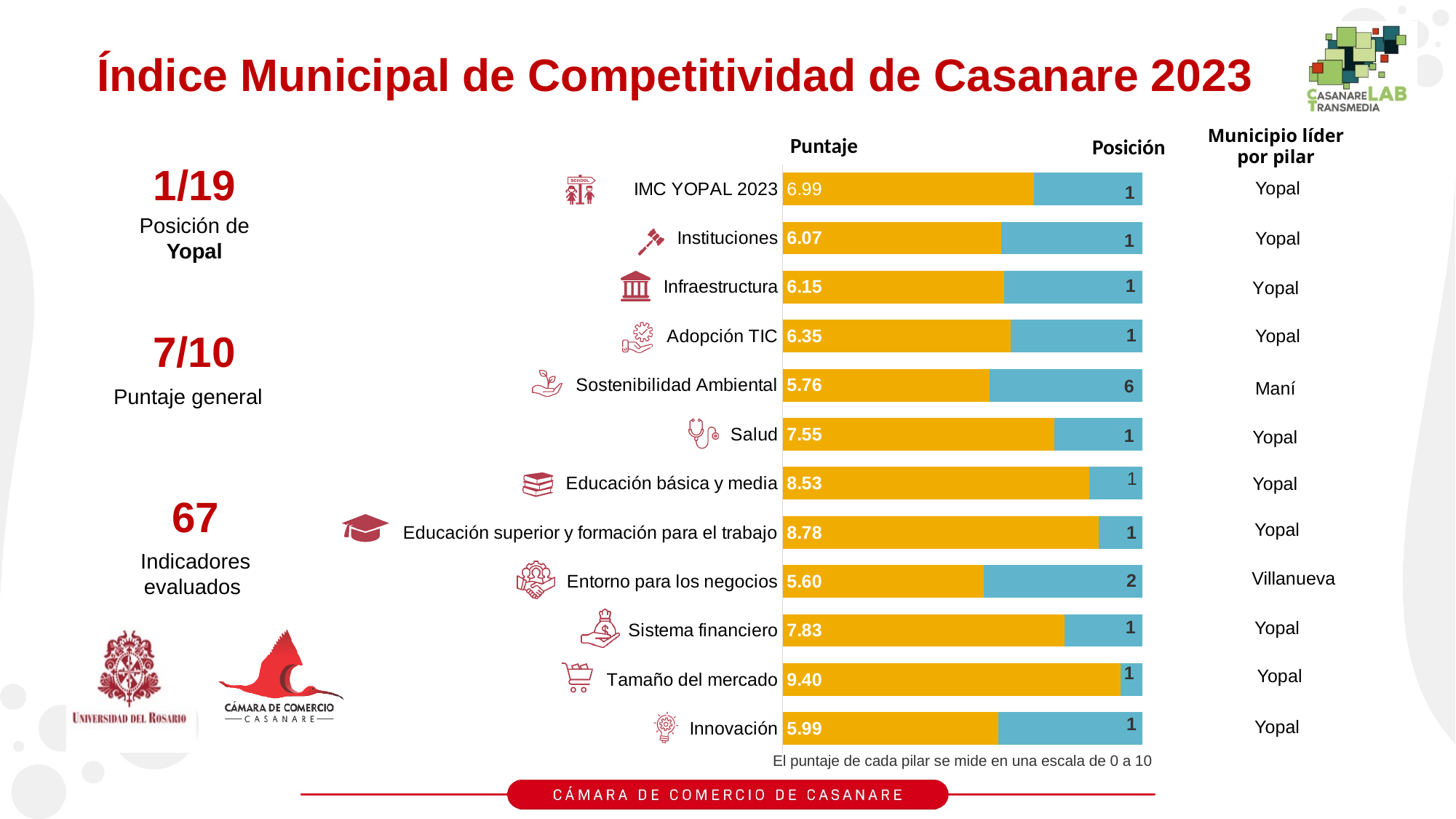
What is the Puntaje for Salud? 7.55 Which pillar has the highest Puntaje? Tamaño del mercado What is the difference between the Puntaje for Educación superior y formación para el trabajo and the Puntaje for Educación básica y media? 0.25 Which has a higher Puntaje, Sistema financiero or Adopción TIC? Sistema financiero How many bars are shown in the chart? 12 What is the Puntaje for Sostenibilidad Ambiental? 5.76 Which pillar has the lowest Puntaje? Entorno para los negocios Which municipality is listed as Municipio líder for Entorno para los negocios? Villanueva What is the Puntaje for Tamaño del mercado? 9.40 What is the difference between the Puntaje for Tamaño del mercado and the Puntaje for Innovación? 3.41 What is the Posición shown for Sostenibilidad Ambiental? 6 What kind of chart is used to show the Puntaje values? Bar chart